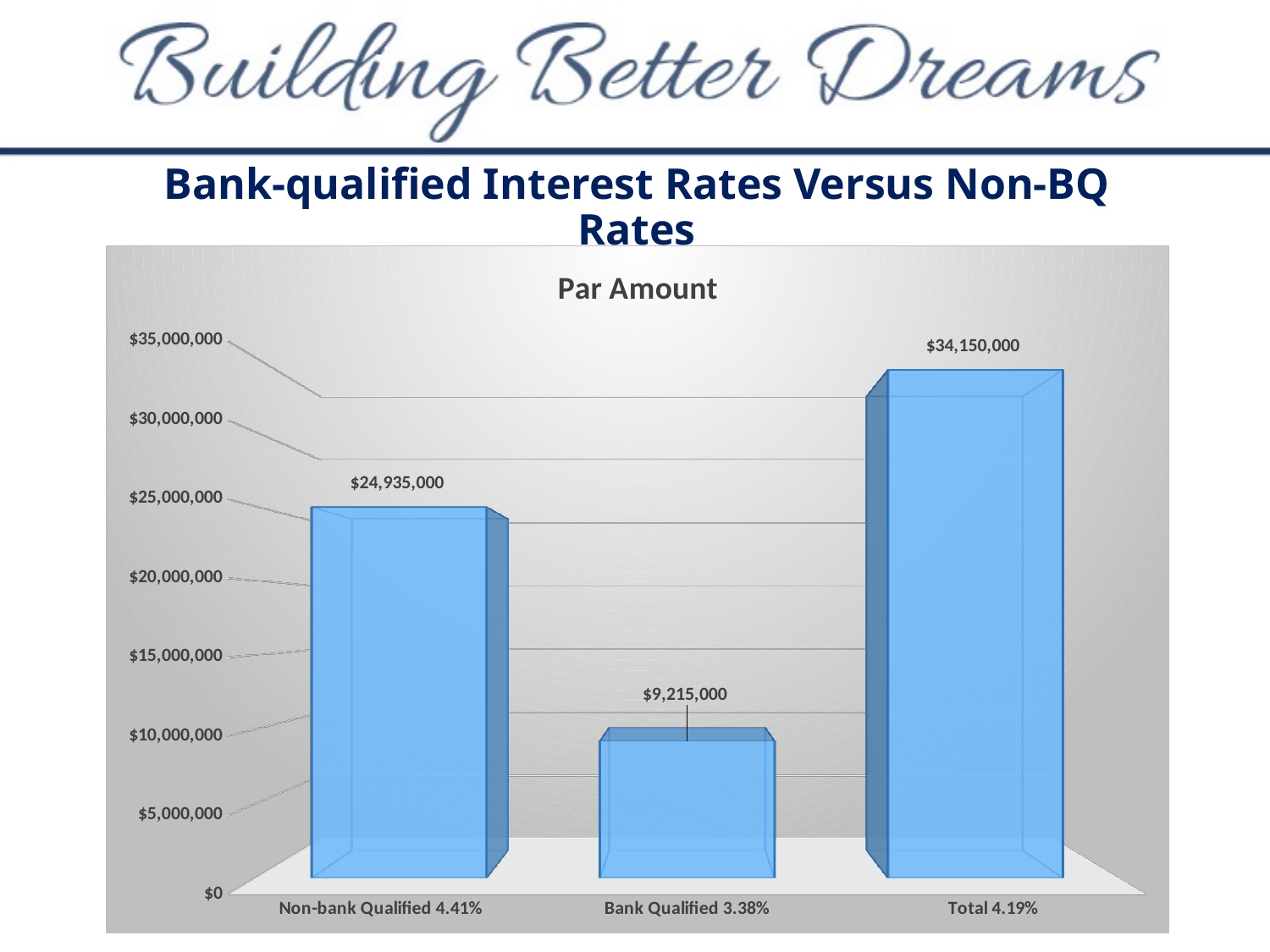
Which category has the highest Par Amount? Total 4.19% What is the Par Amount for Total 4.19%? $34,150,000 What is the difference between the Par Amount for Total 4.19% and Non-bank Qualified 4.41%? $9,215,000 What kind of chart is shown on the slide? bar chart Which category has the lowest Par Amount? Bank Qualified 3.38% What is the Par Amount for Non-bank Qualified 4.41%? $24,935,000 Is the Par Amount for Bank Qualified 3.38% greater or less than $10,000,000? less What is the Par Amount for Bank Qualified 3.38%? $9,215,000 Which is larger, the Par Amount for Non-bank Qualified 4.41% or for Bank Qualified 3.38%? Non-bank Qualified 4.41% What is the title of the chart? Par Amount How many categories are shown in the chart? 3 What is the difference between the Par Amount for Non-bank Qualified 4.41% and Bank Qualified 3.38%? $15,720,000